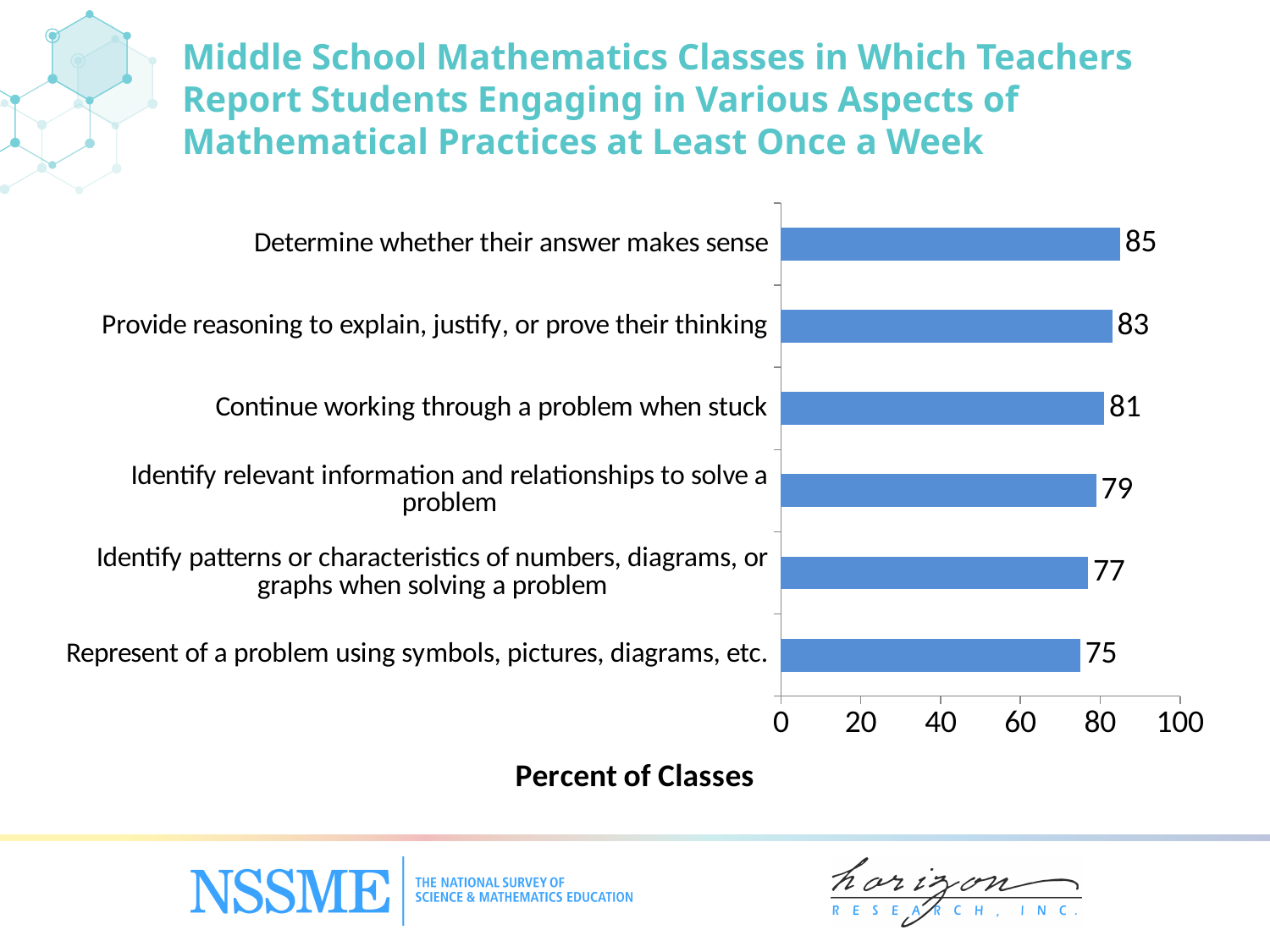
What is the value for "Represent of a problem using symbols, pictures, diagrams, etc."? 75 How many categories are shown in the chart? 6 What is the value for "Continue working through a problem when stuck"? 81 Which category has the lowest percent of classes? Represent of a problem using symbols, pictures, diagrams, etc. Is the value for "Provide reasoning to explain, justify, or prove their thinking" greater or less than 80? greater Which is larger: the value for "Identify relevant information and relationships to solve a problem" or the value for "Identify patterns or characteristics of numbers, diagrams, or graphs when solving a problem"? Identify relevant information and relationships to solve a problem What is the difference between the values for "Determine whether their answer makes sense" and "Represent of a problem using symbols, pictures, diagrams, etc."? 10 What is the difference between the values for "Provide reasoning to explain, justify, or prove their thinking" and "Identify patterns or characteristics of numbers, diagrams, or graphs when solving a problem"? 6 What percent of classes is reported for "Determine whether their answer makes sense"? 85 What kind of chart is shown on the slide? bar chart What is the label of the horizontal axis? Percent of Classes Which category has the highest percent of classes? Determine whether their answer makes sense